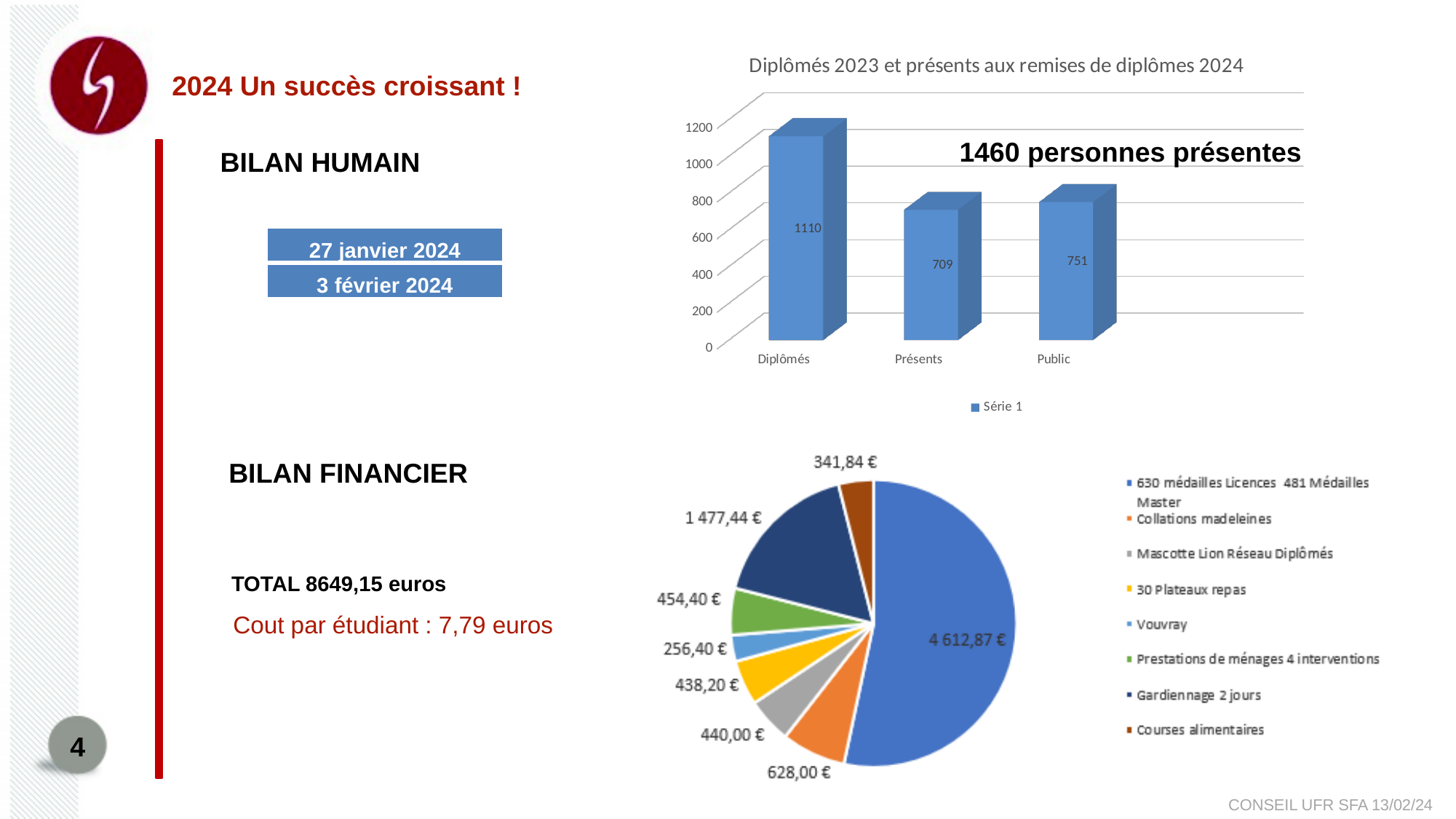
In the pie chart at the bottom of the slide, which category has the largest slice? 630 médailles Licences 481 Médailles Master What kind of chart is the chart titled 'Diplômés 2023 et présents aux remises de diplômes 2024'? bar chart In the bar chart 'Diplômés 2023 et présents aux remises de diplômes 2024', which is larger, Public or Présents? Public In the pie chart at the bottom of the slide, what is the value of the smallest slice? 256,40 € In the bar chart 'Diplômés 2023 et présents aux remises de diplômes 2024', what is the difference between Diplômés and Présents? 401 In the bar chart 'Diplômés 2023 et présents aux remises de diplômes 2024', what is the value for Diplômés? 1110 In the bar chart 'Diplômés 2023 et présents aux remises de diplômes 2024', what is the value for Présents? 709 How many slices does the pie chart at the bottom of the slide have? 8 In the pie chart at the bottom of the slide, what is the value for 'Gardiennage 2 jours'? 1 477,44 € In the bar chart 'Diplômés 2023 et présents aux remises de diplômes 2024', which category has the lowest value? Présents What series name does the legend of the bar chart 'Diplômés 2023 et présents aux remises de diplômes 2024' list? Série 1 How many categories are shown in the bar chart 'Diplômés 2023 et présents aux remises de diplômes 2024'? 3